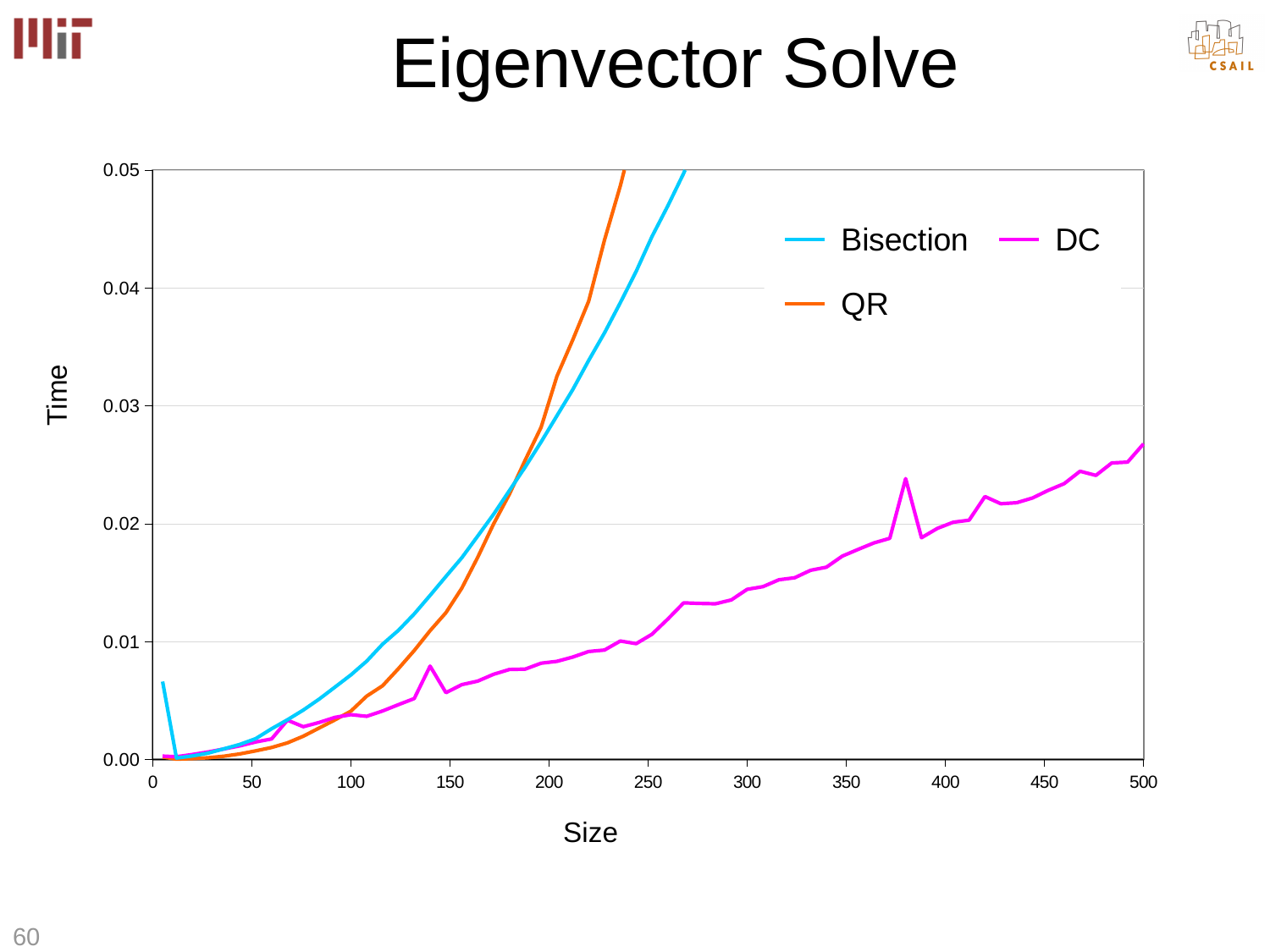
How many series does the legend list? 3 At size 225, which series has the larger time, QR or Bisection? QR Is the value for DC at size 500 greater or less than 0.03? less Which series reaches a time of 0.05 at the smallest size? QR Is the value for Bisection at size 200 greater or less than 0.02? greater What are the labels of the x axis and the y axis? Size and Time What are the series names listed in the legend? Bisection, DC, QR Does the time for DC generally rise or fall as size increases? rise Is the value for DC at size 300 greater or less than 0.02? less What kind of chart is shown on the slide? line chart